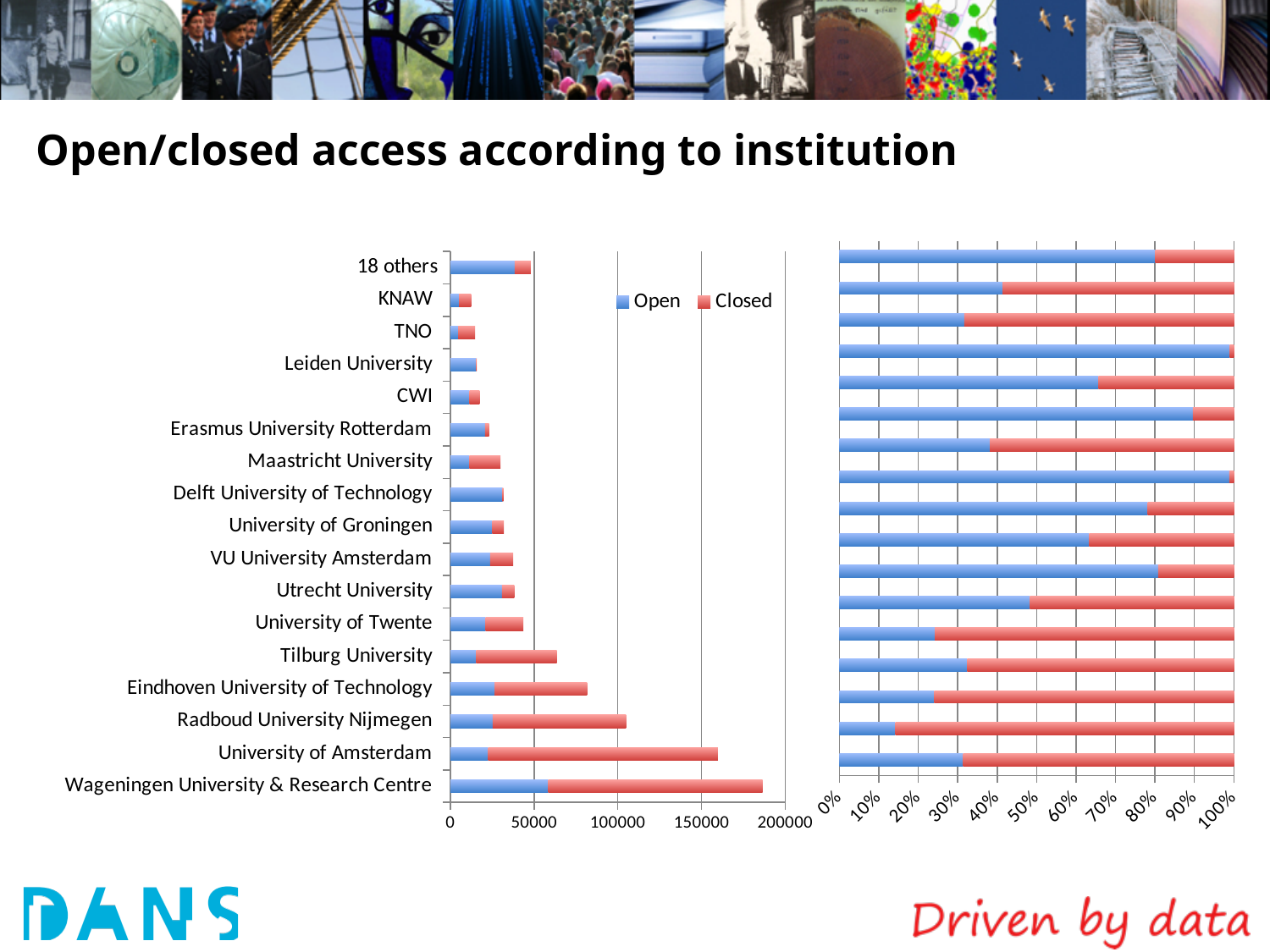
What are the two series named in the legend of the left chart? Open and Closed In the left chart, is the total bar for University of Twente greater or less than 50000? less In the left chart, which institution has the longest total bar? Wageningen University & Research Centre How many series does the legend of the left chart list? 2 In the left chart, which has the larger total bar: University of Amsterdam or Radboud University Nijmegen? University of Amsterdam What is the title of the slide's chart section? Open/closed access according to institution In the left chart, is the total bar for Eindhoven University of Technology greater or less than 100000? less What kind of chart is the left chart on the slide? Stacked bar chart In the left chart, do the total bars increase or decrease from the top row to the bottom row? increase In the left chart, is the total bar for Wageningen University & Research Centre greater or less than 150000? greater How many institution categories are shown on the left chart? 17